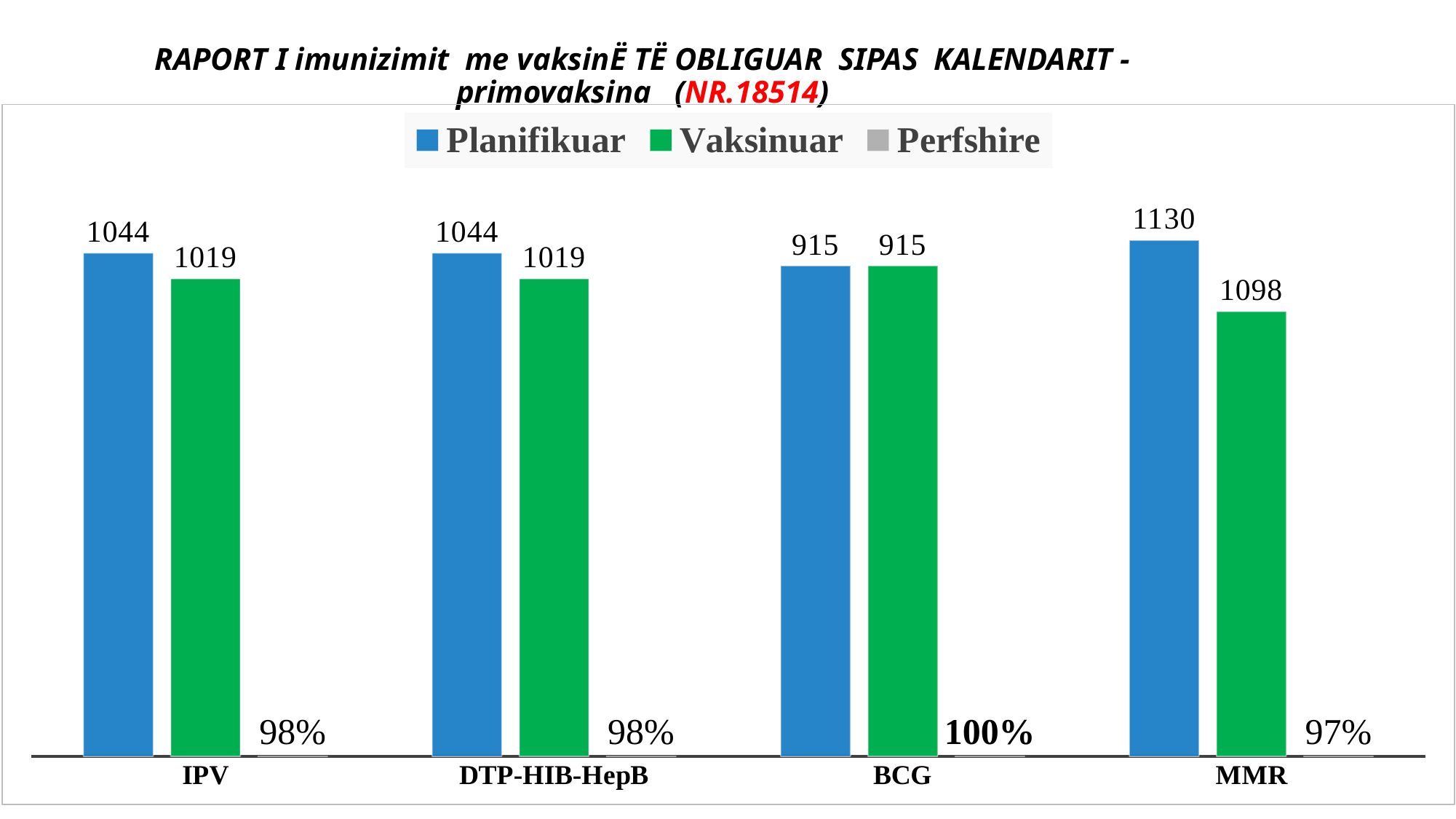
Which category has the lowest Vaksinuar value? BCG What is the Planifikuar value for MMR? 1130 What is the Perfshire value for MMR? 97% Which category has the highest Planifikuar value? MMR What kind of chart is shown on the slide? Bar chart How many categories are shown on the x axis? 4 What is the Perfshire value for BCG? 100% Which is larger for DTP-HIB-HepB, the Planifikuar value or the Vaksinuar value? Planifikuar What is the Vaksinuar value for IPV? 1019 What is the difference between the Planifikuar and Vaksinuar values for IPV? 25 How many series does the legend list? 3 What is the difference between the Planifikuar and Vaksinuar values for MMR? 32